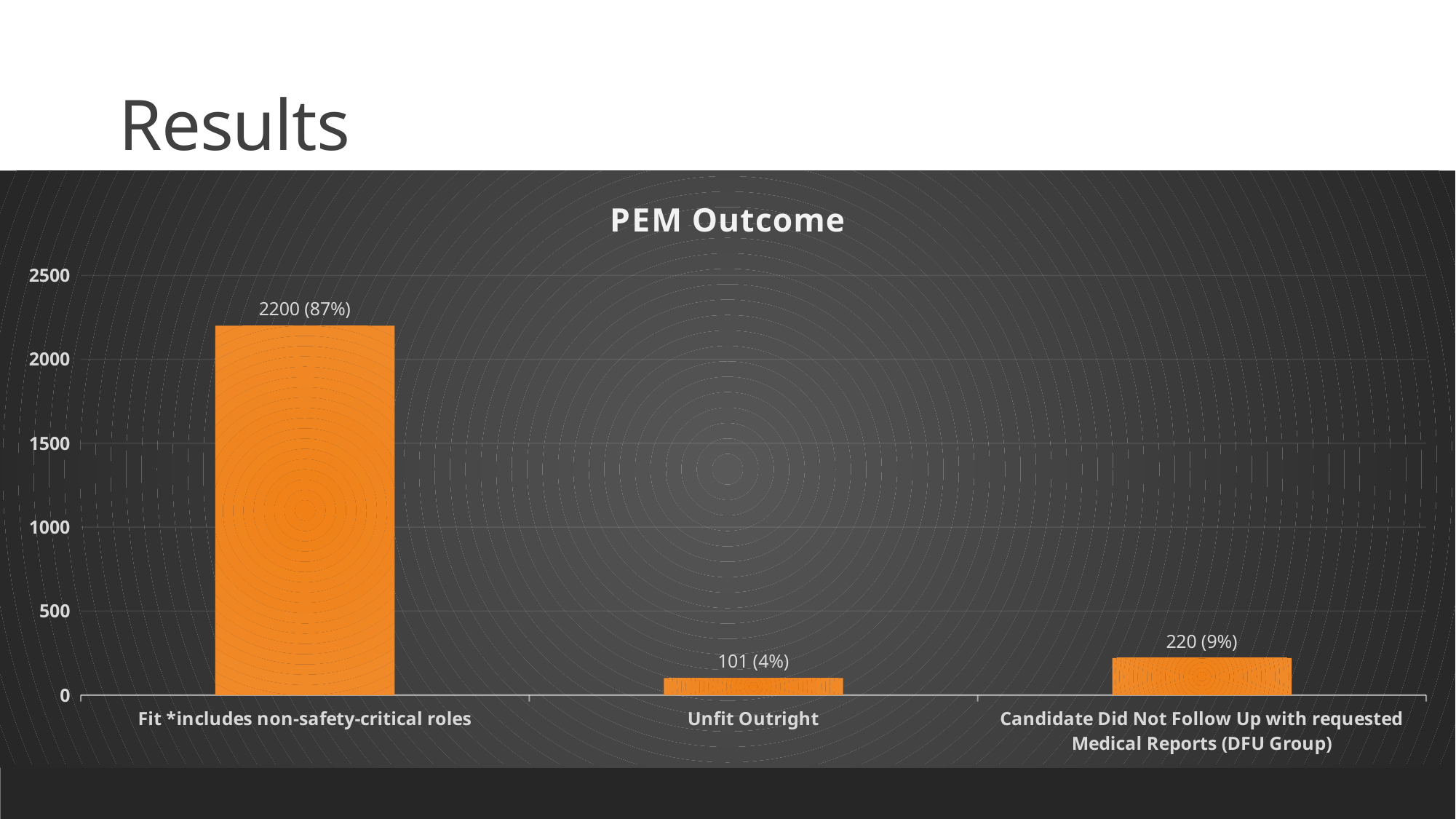
What is the value shown for Fit *includes non-safety-critical roles? 2200 (87%) What is the difference between the DFU Group count and the Unfit Outright count? 119 Which is larger, the value for Unfit Outright or the value for the DFU Group? DFU Group Which category has the highest value? Fit *includes non-safety-critical roles Is the value for Fit *includes non-safety-critical roles greater or less than 2000? greater What kind of chart is this? bar chart What is the title of the chart? PEM Outcome Which category has the lowest value? Unfit Outright What is the value shown for Candidate Did Not Follow Up with requested Medical Reports (DFU Group)? 220 (9%) How many categories are shown on the x axis? 3 What is the value shown for Unfit Outright? 101 (4%) What is the difference between the Fit count and the DFU Group count? 1980